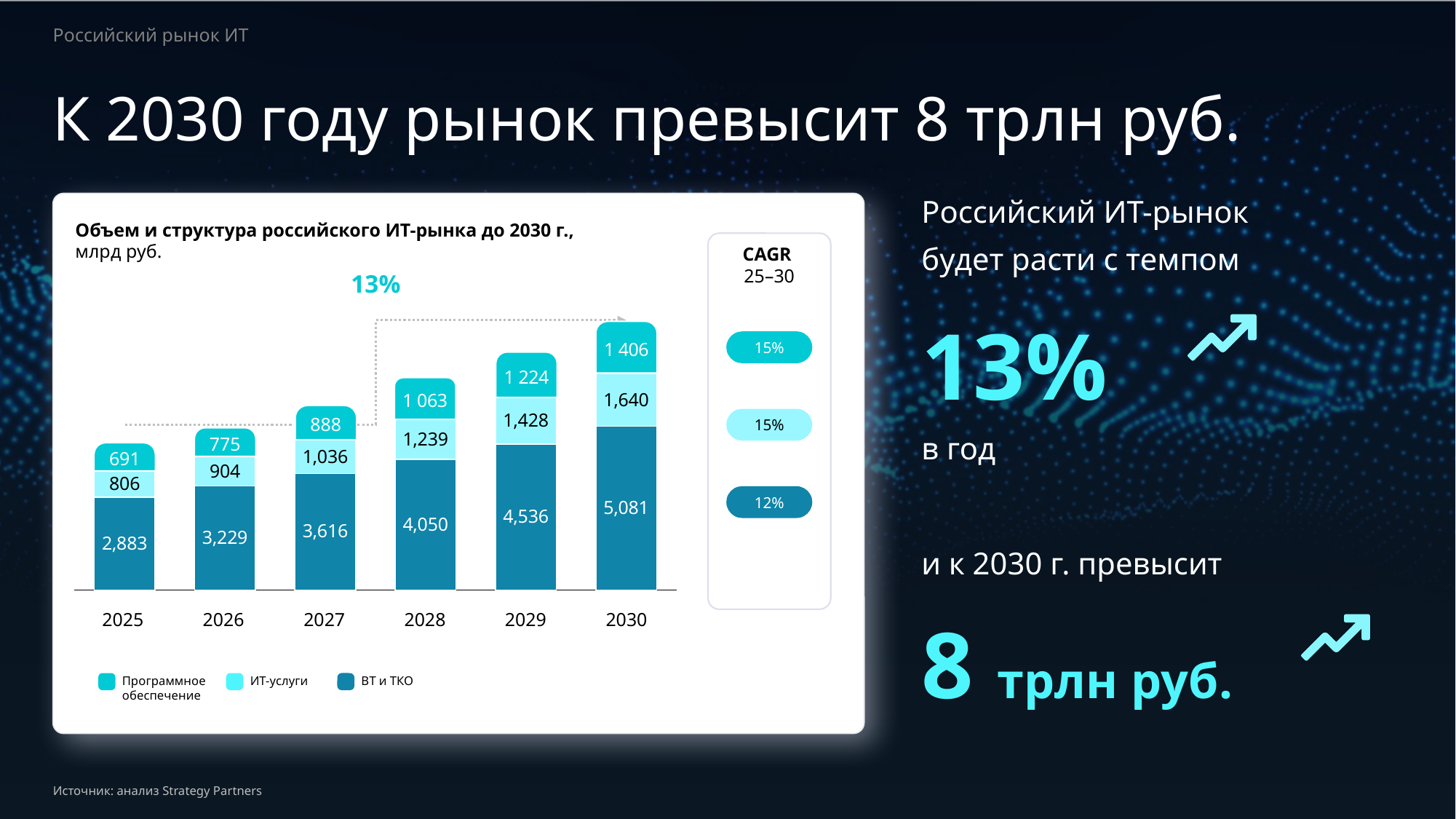
What is the value for ВТ и ТКО in 2030? 5,081 In which year is the Программное обеспечение segment the smallest? 2025 What is the value for Программное обеспечение in 2025? 691 What is the total of the stacked bar for 2030? 8,127 What kind of chart is shown on the slide? Stacked bar chart How many series does the chart legend list? 3 How many years are shown on the x axis of the chart? 6 Which is larger: ИТ-услуги in 2029 or Программное обеспечение in 2029? ИТ-услуги in 2029 What is the value for ИТ-услуги in 2028? 1,239 Do the ВТ и ТКО values rise or fall from 2025 to 2030? Rise What is the difference between the ВТ и ТКО values for 2030 and 2025? 2,198 In which year is the ВТ и ТКО segment the largest? 2030